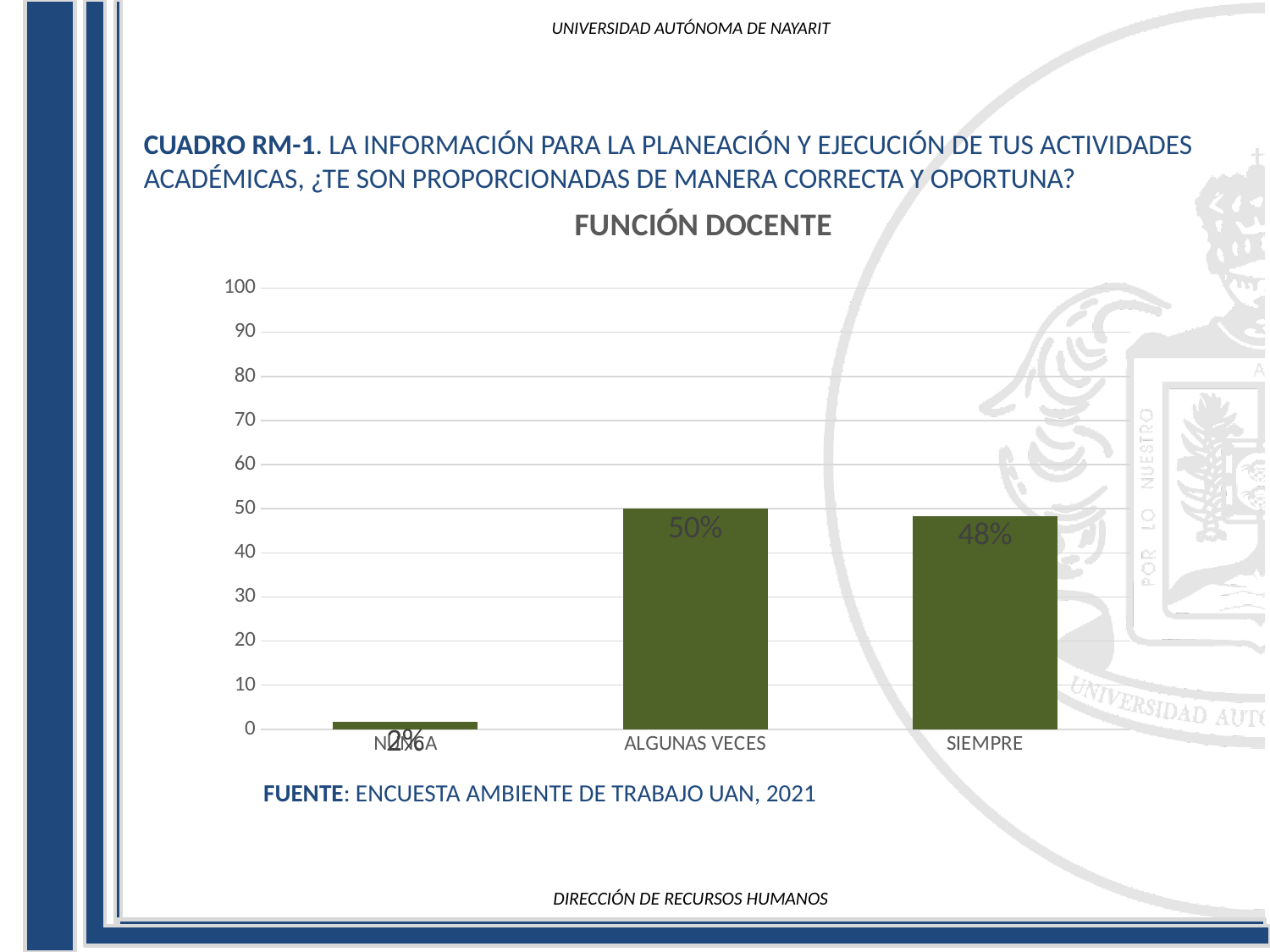
What kind of chart is shown under the title FUNCIÓN DOCENTE? bar chart Which category has the lowest value? NUNCA What is the value for ALGUNAS VECES? 50% What is the title of the chart? FUNCIÓN DOCENTE Which category has the highest value? ALGUNAS VECES What is the value for NUNCA? 2% What is the value for SIEMPRE? 48% Which is larger, the value for SIEMPRE or the value for NUNCA? SIEMPRE How many categories are shown on the x axis of the chart? 3 Is the value for SIEMPRE greater or less than 40? greater What is the difference between the values for ALGUNAS VECES and SIEMPRE? 2% What is the difference between the values for SIEMPRE and NUNCA? 46%